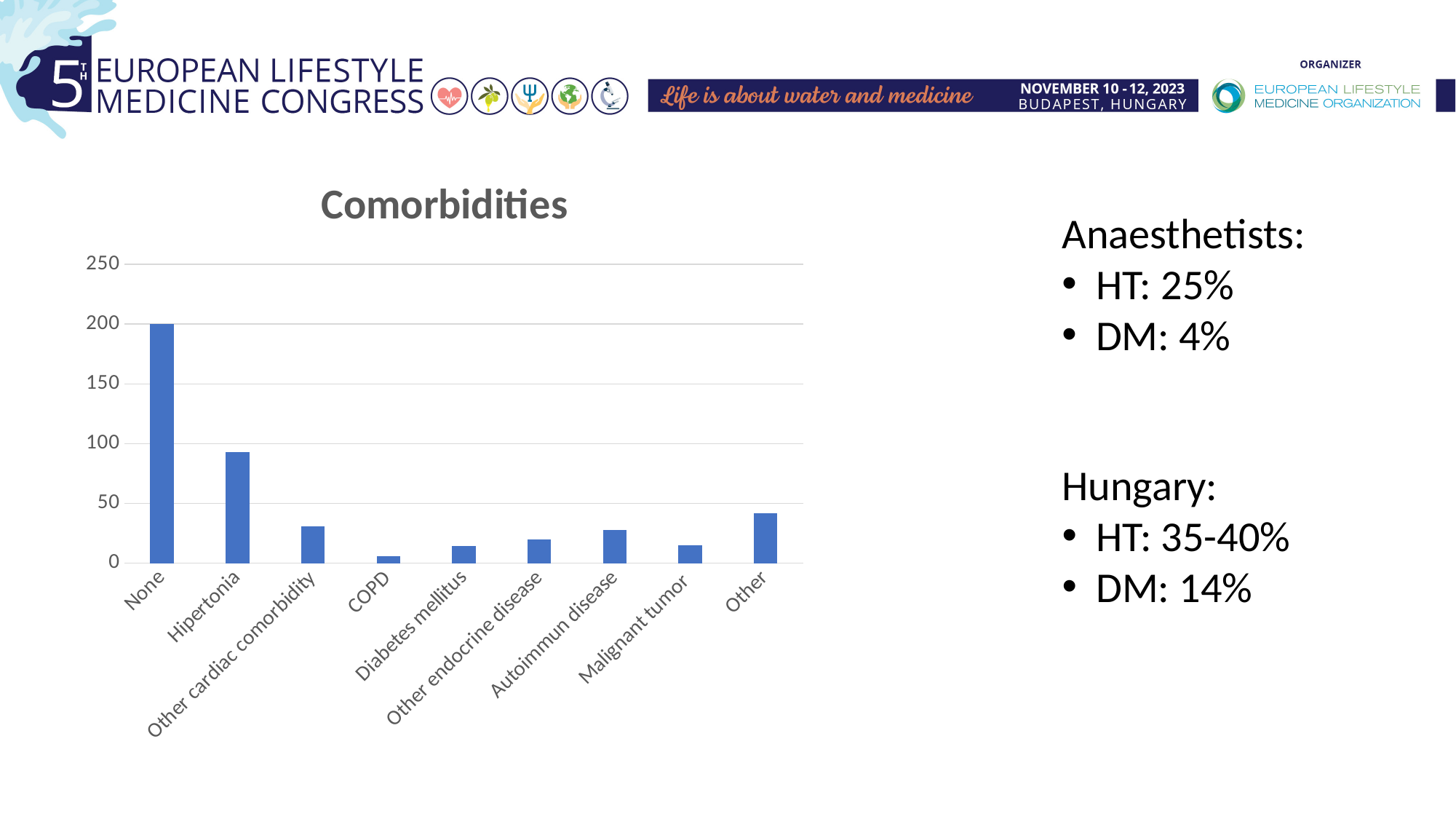
What is the title of the chart? Comorbidities Is the value for Hipertonia greater or less than 50? greater How many categories are shown on the x axis of the chart? 9 Is the value for Hipertonia greater or less than 100? less Is the value for COPD greater or less than 50? less What is the value for None in the chart? 200 Which category has the lowest bar in the chart? COPD What kind of chart is shown on the slide? bar chart Which category has the highest bar in the chart? None Which is larger, the value for Hipertonia or the value for Other cardiac comorbidity? Hipertonia Which is larger, the value for Other or the value for Malignant tumor? Other